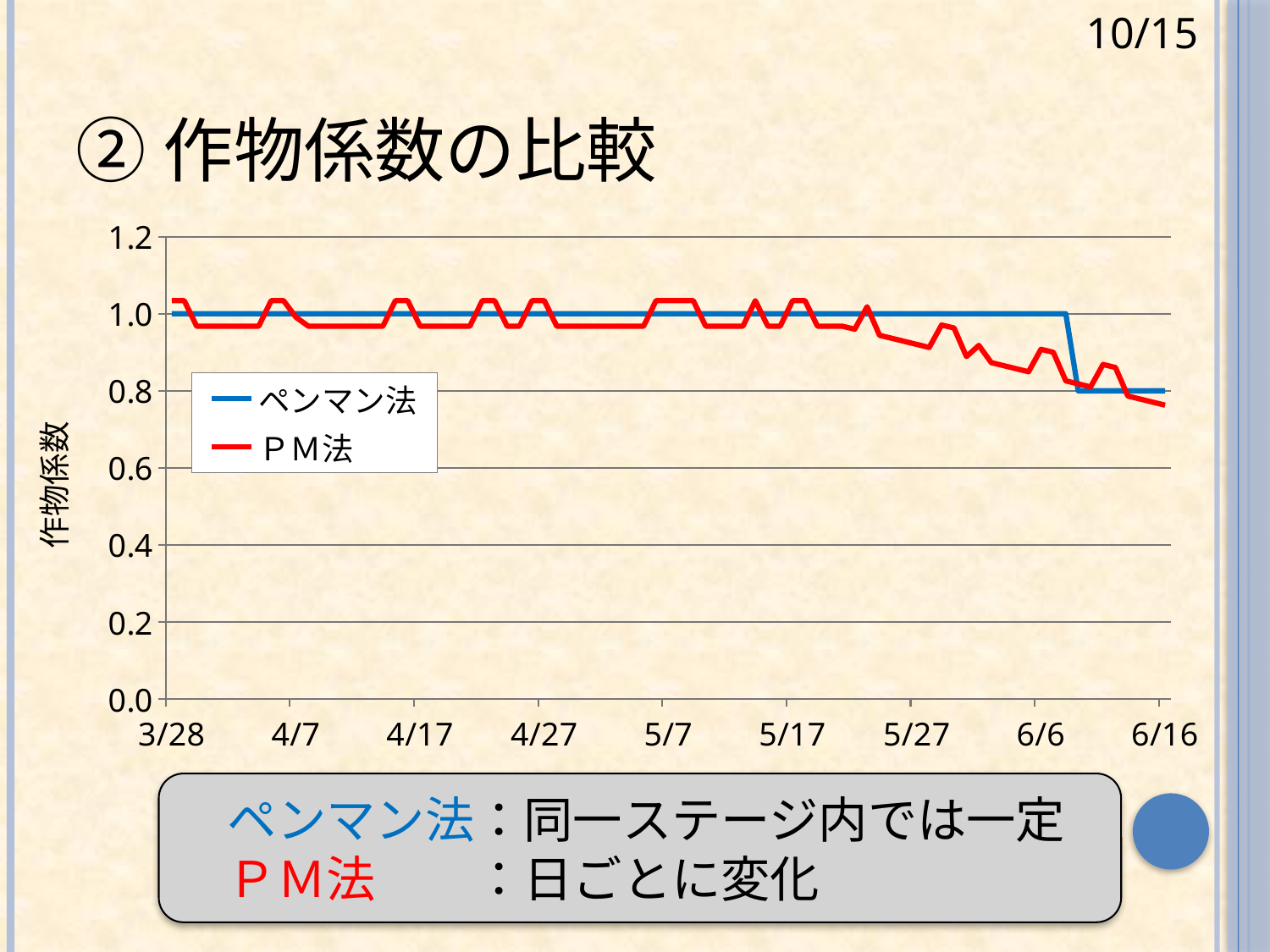
Do the values of ＰＭ法 rise or fall from 5/17 to 6/16? fall Is the value of ペンマン法 on 6/16 greater or less than 1.0? less What is the value of ペンマン法 on 4/7? 1.0 Is the value of ＰＭ法 on 5/27 greater or less than 0.8? greater On 6/6, which series has the higher value, ペンマン法 or ＰＭ法? ペンマン法 What is the value of ペンマン法 on 6/16? 0.8 How many date labels are shown on the horizontal axis? 9 What is the title of the chart on the slide? ② 作物係数の比較 How many series does the legend list? 2 What is the label on the vertical axis? 作物係数 What kind of chart is shown on the slide? line chart Is the value of ＰＭ法 on 6/16 greater or less than 1.0? less